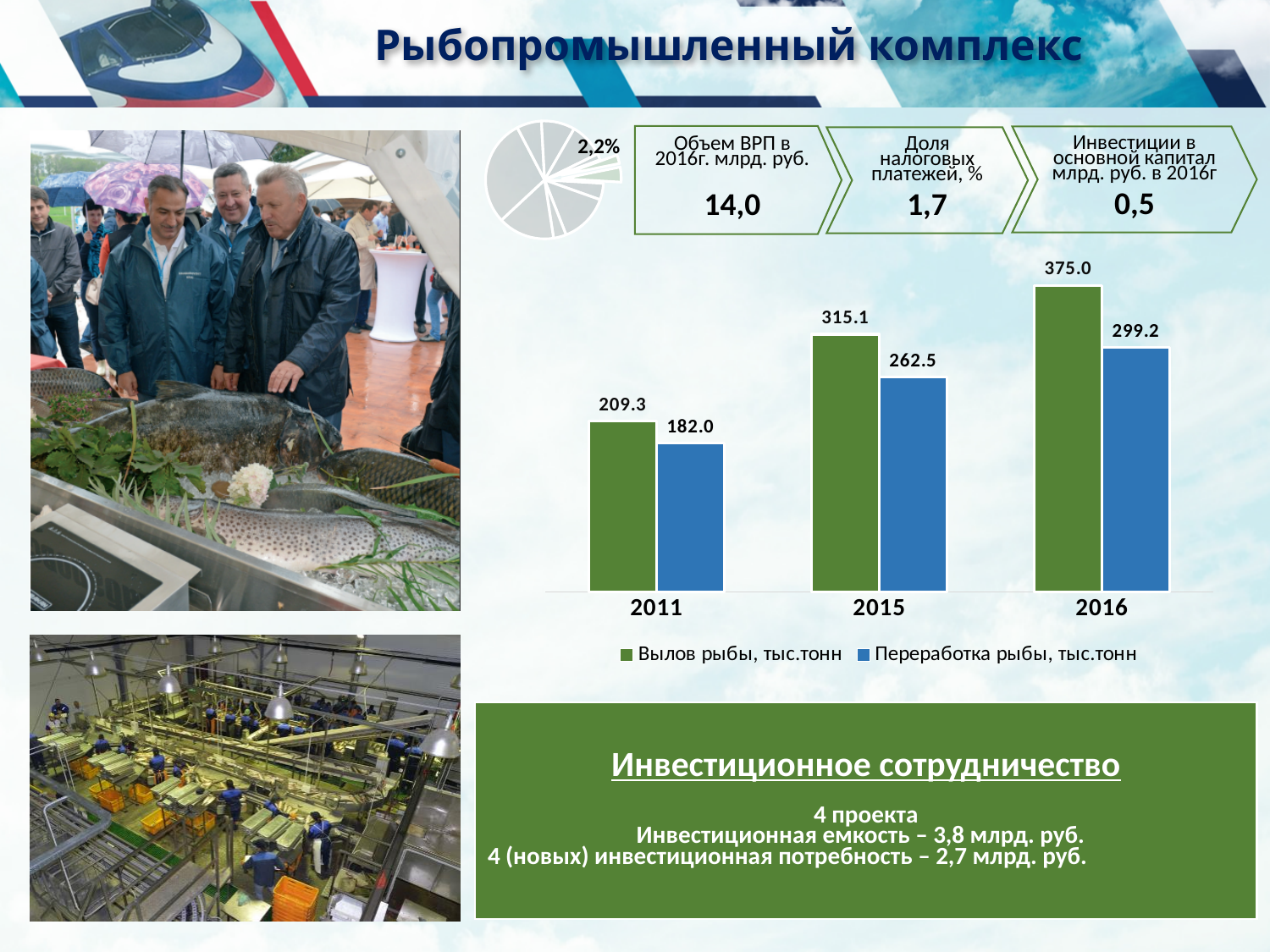
In the bar chart, what is the difference between Вылов рыбы and Переработка рыбы in 2016? 75.8 How many series does the legend of the bar chart list? 2 How many years are shown on the x axis of the bar chart? 3 In the bar chart, which year has the highest value for Вылов рыбы, тыс.тонн? 2016 In the bar chart, what is the difference between Вылов рыбы in 2015 and Вылов рыбы in 2011? 105.8 In the bar chart, which year has the lowest value for Переработка рыбы, тыс.тонн? 2011 In the bar chart, what is the value of Переработка рыбы, тыс.тонн for 2015? 262.5 In the bar chart, does Переработка рыбы, тыс.тонн rise or fall from 2011 to 2016? Rise In the bar chart, what is the value of Вылов рыбы, тыс.тонн for 2016? 375.0 What type of chart shows the Вылов рыбы and Переработка рыбы data? Bar chart In the bar chart, which is larger in 2015: Вылов рыбы or Переработка рыбы? Вылов рыбы In the bar chart, what is the value of Переработка рыбы, тыс.тонн for 2011? 182.0